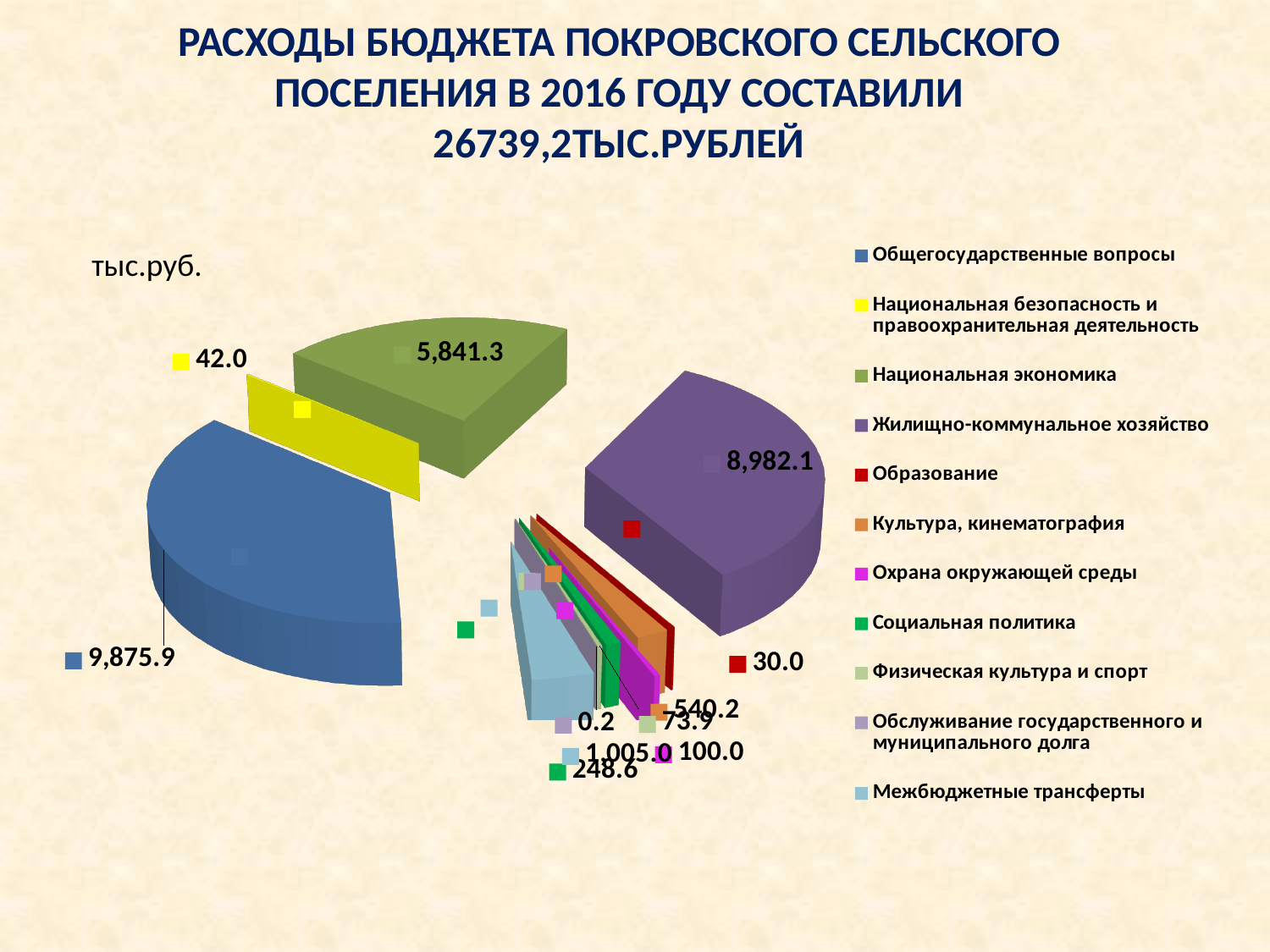
What is the difference between the values for Общегосударственные вопросы and Жилищно-коммунальное хозяйство? 893.8 What kind of chart is shown on the slide? Pie chart What is the value for Образование? 30.0 How many categories does the legend list? 11 What is the value for Обслуживание государственного и муниципального долга? 0.2 What is the value for Национальная экономика? 5,841.3 Which category has the largest value? Общегосударственные вопросы What is the value for Жилищно-коммунальное хозяйство? 8,982.1 Which is larger, the value for Культура, кинематография or the value for Социальная политика? Культура, кинематография What is the value for Общегосударственные вопросы? 9,875.9 What is the value for Национальная безопасность и правоохранительная деятельность? 42.0 Which category has the smallest value? Обслуживание государственного и муниципального долга